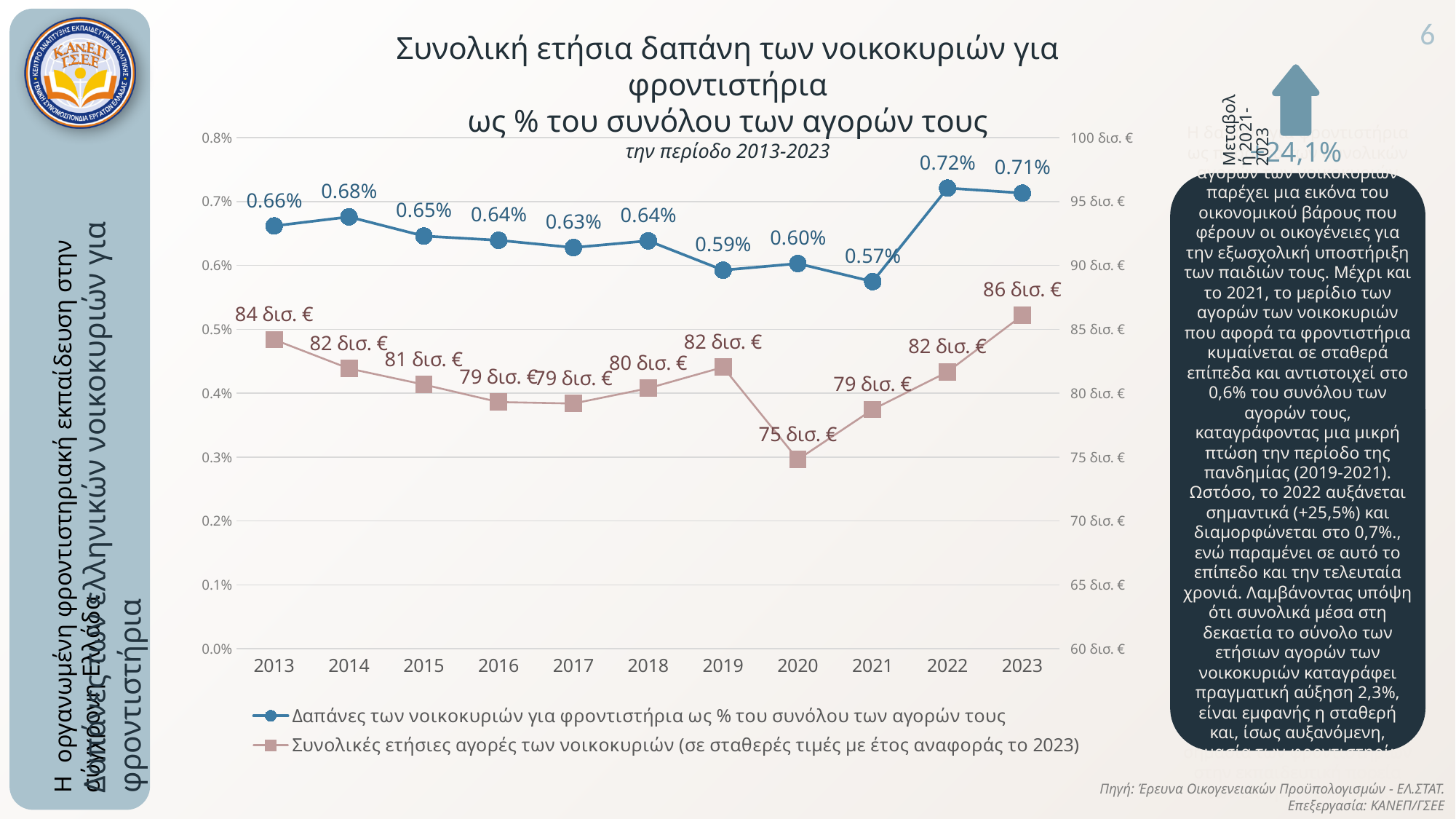
In which year are total annual household purchases lowest? 2020 How many years are plotted along the x axis? 11 Which year has the larger value of total annual household purchases, 2014 or 2021? 2014 What is the difference between total annual household purchases in 2023 and in 2013? 2 δισ. € Does the spending on φροντιστήρια as % of total purchases rise or fall from 2013 to 2021? fall What is the value of total annual household purchases (Συνολικές ετήσιες αγορές) in 2020? 75 δισ. € What is the value of household spending on φροντιστήρια as % of total purchases in 2021? 0.57% In which year is household spending on φροντιστήρια as % of total purchases highest? 2022 What period does the chart subtitle say the data covers? 2013-2023 How many series does the legend list? 2 What type of chart is shown on the slide? line chart What is the difference between the 2022 and 2021 values of spending on φροντιστήρια as % of total purchases? 0.15%